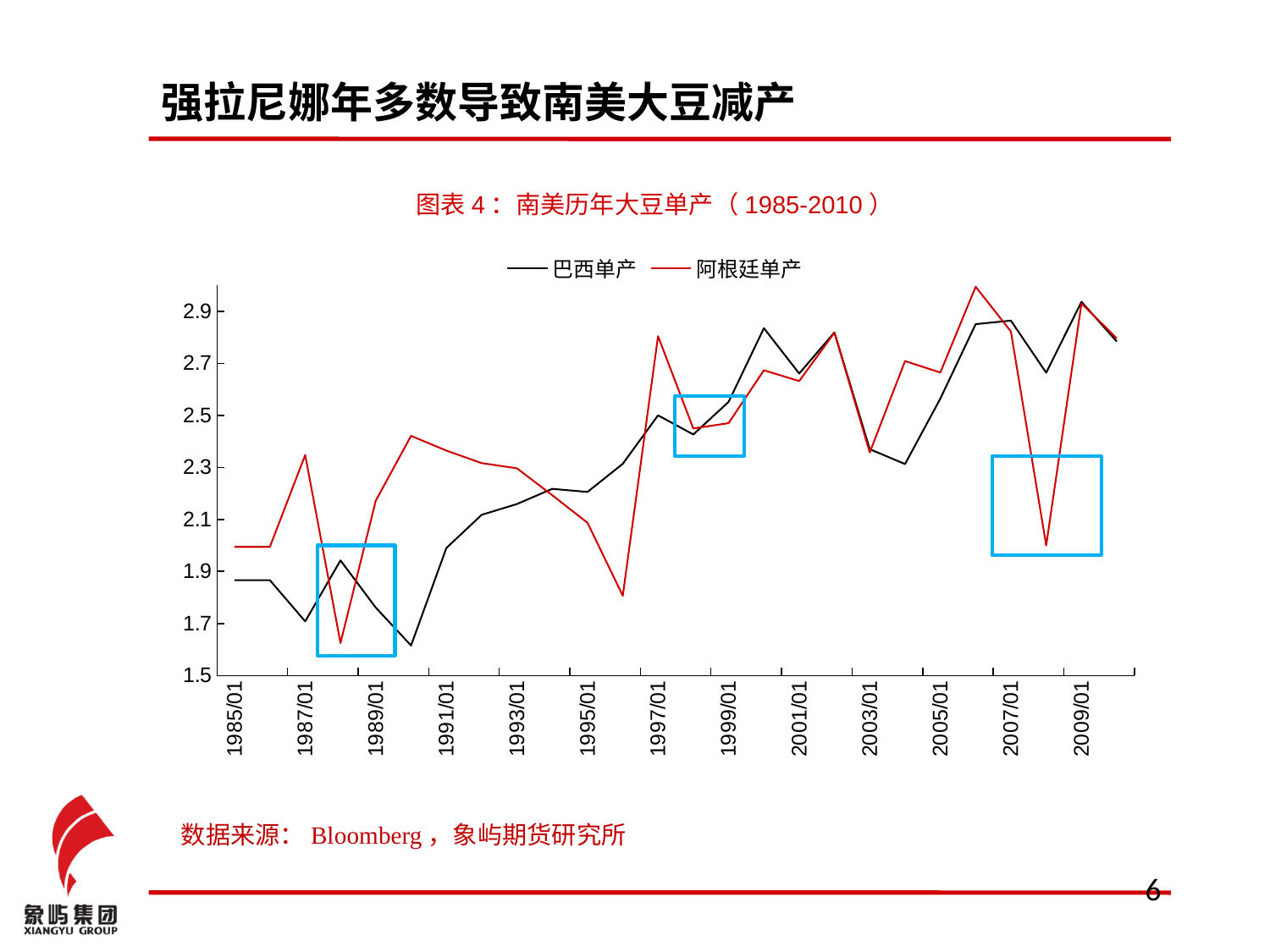
Is the value for 巴西单产 at 2000/01 greater or less than 2.7? greater What is the title of the chart? 图表4：南美历年大豆单产（1985-2010） What kind of chart is shown on the slide? line chart What are the two series named in the legend? 巴西单产 and 阿根廷单产 Is the value for 巴西单产 at 1990/01 greater or less than 1.7? less Is the value for 阿根廷单产 at 1996/01 greater or less than 1.9? less At 1996/01, which series has the larger value, 巴西单产 or 阿根廷单产? 巴西单产 Does 巴西单产 generally rise or fall from 1990/01 to 2000/01? rise At 1990/01, which series has the larger value, 巴西单产 or 阿根廷单产? 阿根廷单产 At 2008/01, which series has the larger value, 巴西单产 or 阿根廷单产? 巴西单产 How many series does the legend list? 2